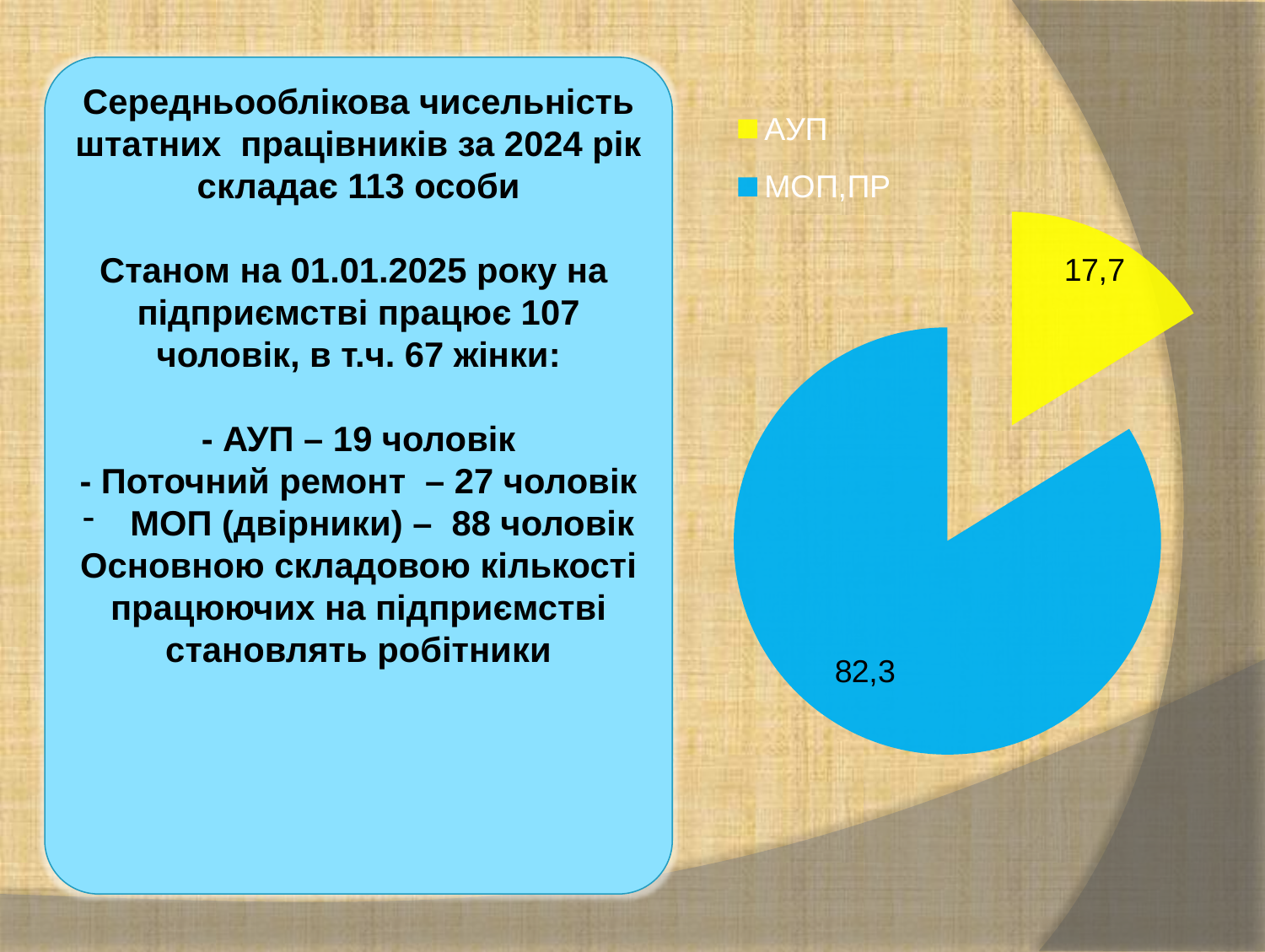
What colour is the МОП,ПР slice? blue Which category has the largest slice of the pie? МОП,ПР What type of chart is shown on the slide? pie chart Which category has the smallest slice of the pie? АУП How many slices does the pie chart have? 2 What is the value shown for the МОП,ПР slice? 82,3 Which is larger, the АУП slice or the МОП,ПР slice? МОП,ПР What is the value shown for the АУП slice? 17,7 How many entries does the legend list? 2 What is the difference between the МОП,ПР value and the АУП value? 64,6 What colour is the АУП slice? yellow